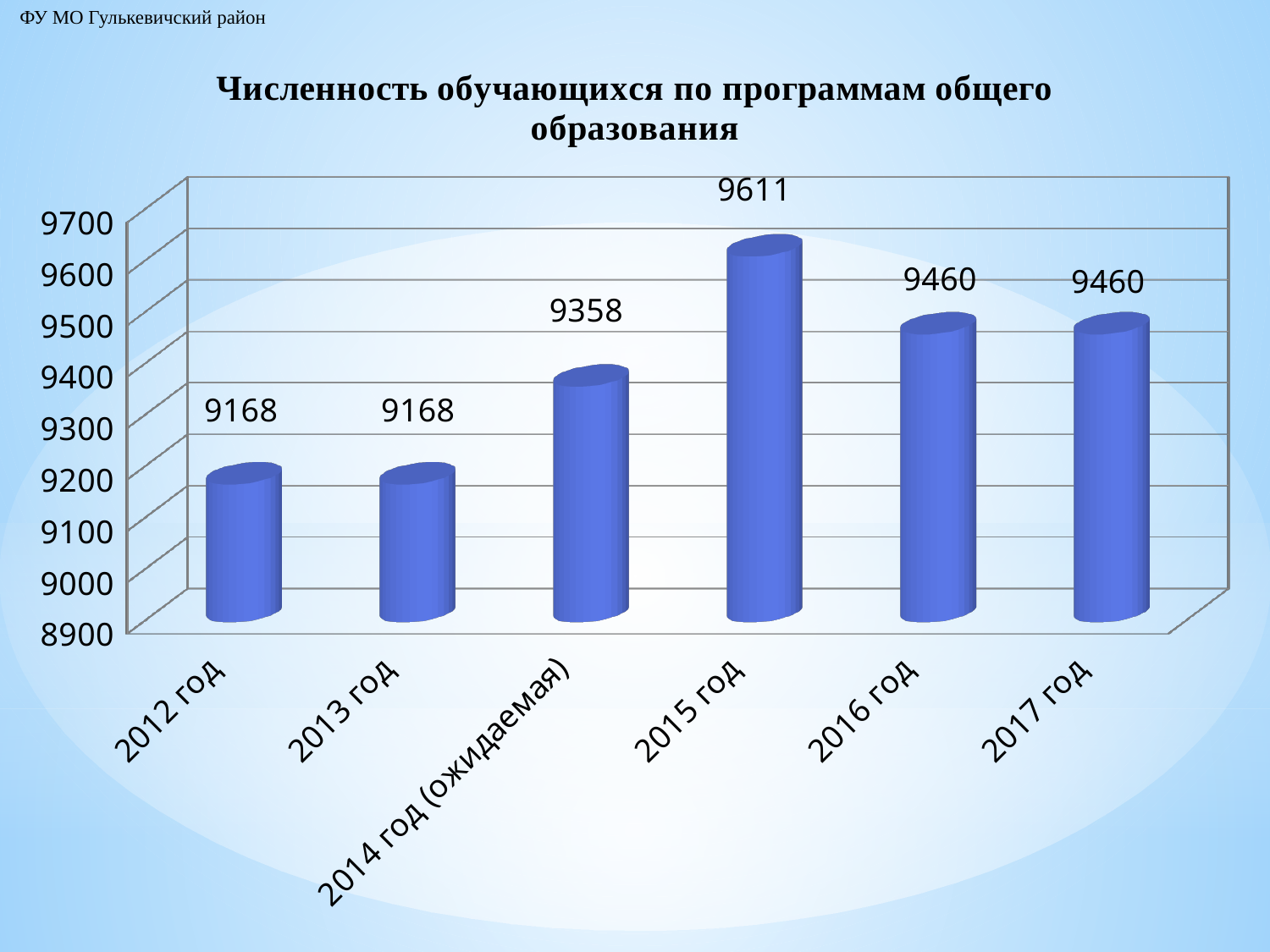
How many categories are shown on the x axis? 6 What is the difference between the values for 2015 год and 2014 год (ожидаемая)? 253 Do the values rise or fall from 2013 год to 2015 год? rise What is the value for 2015 год? 9611 Is the value for 2016 год greater or less than 9400? greater What is the value for 2012 год? 9168 What kind of chart is shown on the slide? bar chart Which is larger, the value for 2015 год or the value for 2017 год? 2015 год What is the title of the chart? Численность обучающихся по программам общего образования Which category has the highest value? 2015 год What is the difference between the values for 2016 год and 2013 год? 292 What is the value for 2014 год (ожидаемая)? 9358